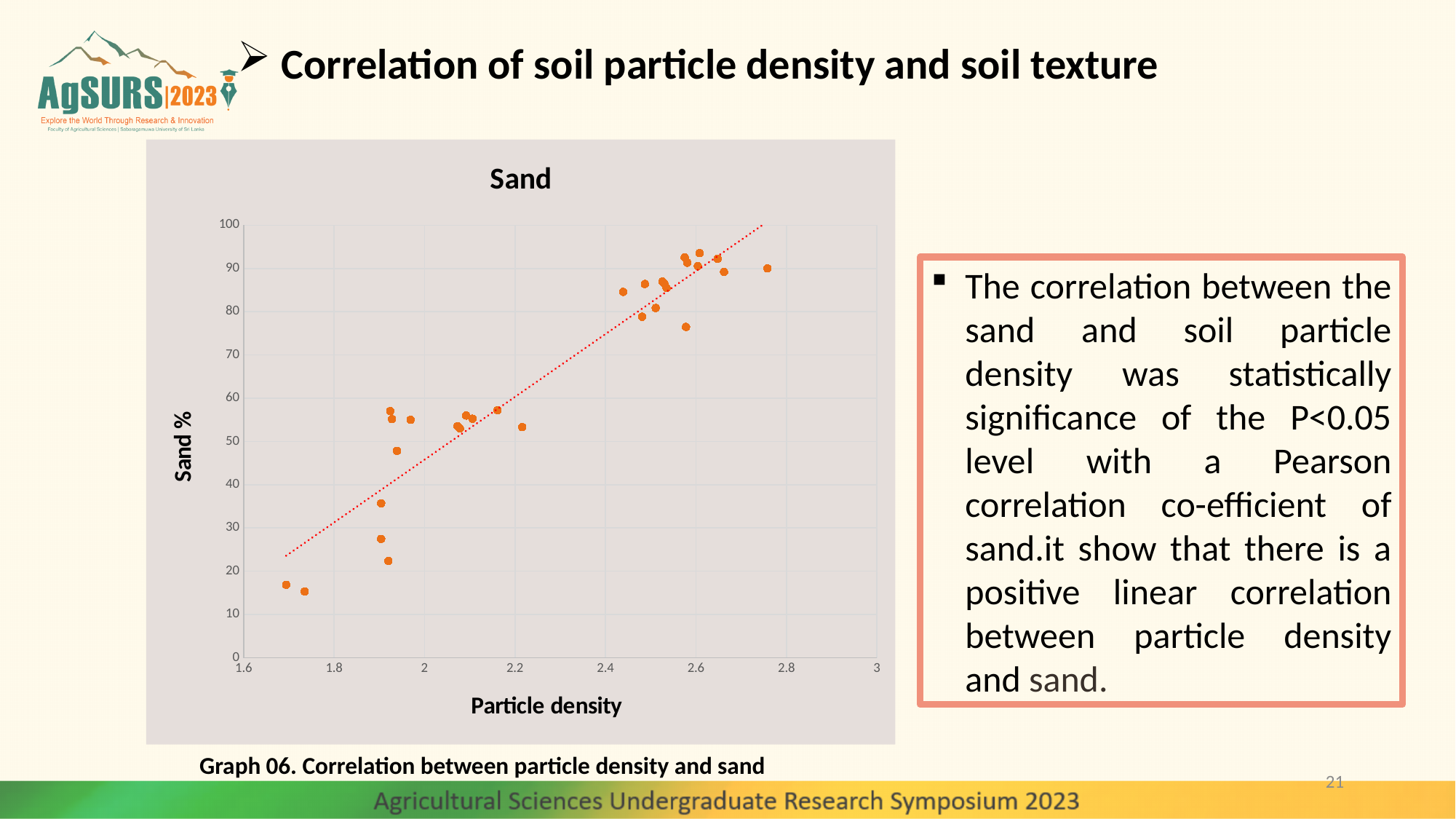
What kind of chart is shown on the slide? scatter chart What is the highest value shown on the y axis of the chart? 100 Is the sand % for the point at particle density around 2.44 greater or less than 80? greater Is the sand % for the point at particle density around 1.93 with the lowest value in that cluster greater or less than 30? less What is the label of the x axis of the chart? Particle density Which has the larger sand %: the point at particle density around 1.7 or the point at particle density around 2.6? the point at particle density around 2.6 Is the sand % for the leftmost point (particle density around 1.7) greater or less than 20? less Do the sand % values generally rise or fall as particle density increases along the x axis? rise What is the title of the chart? Sand